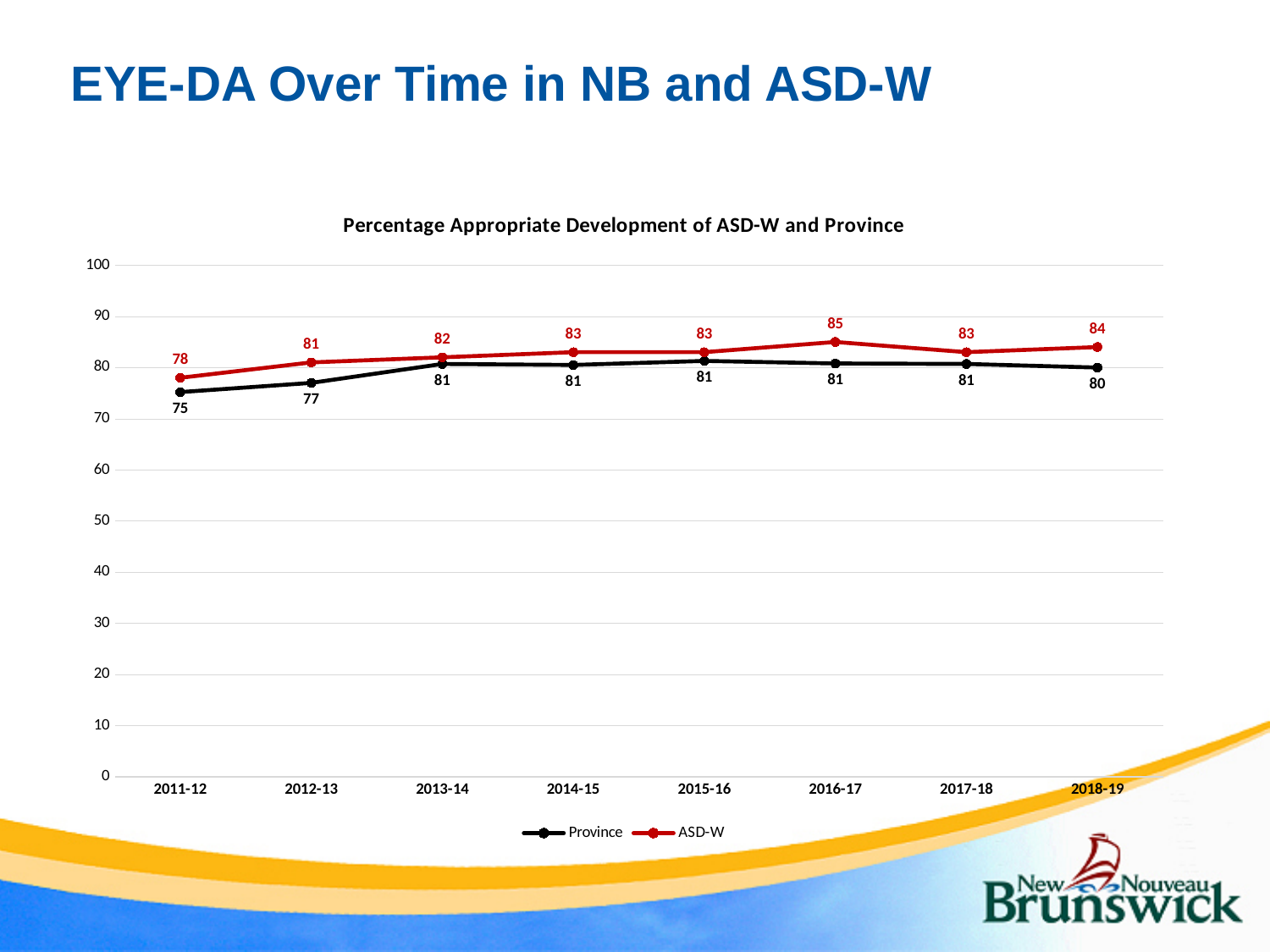
How many series does the legend list? 2 Which series has the higher value in 2012-13, Province or ASD-W? ASD-W What is the ASD-W value for 2016-17? 85 Does the Province value rise or fall from 2011-12 to 2013-14? rise What is the difference between the ASD-W and Province values in 2016-17? 4 In which year is the Province value lowest? 2011-12 In which year is the ASD-W value highest? 2016-17 How many years are shown on the x axis? 8 What kind of chart is this? line chart What is the Province value for 2018-19? 80 What is the Province value for 2011-12? 75 What is the title of the chart? Percentage Appropriate Development of ASD-W and Province